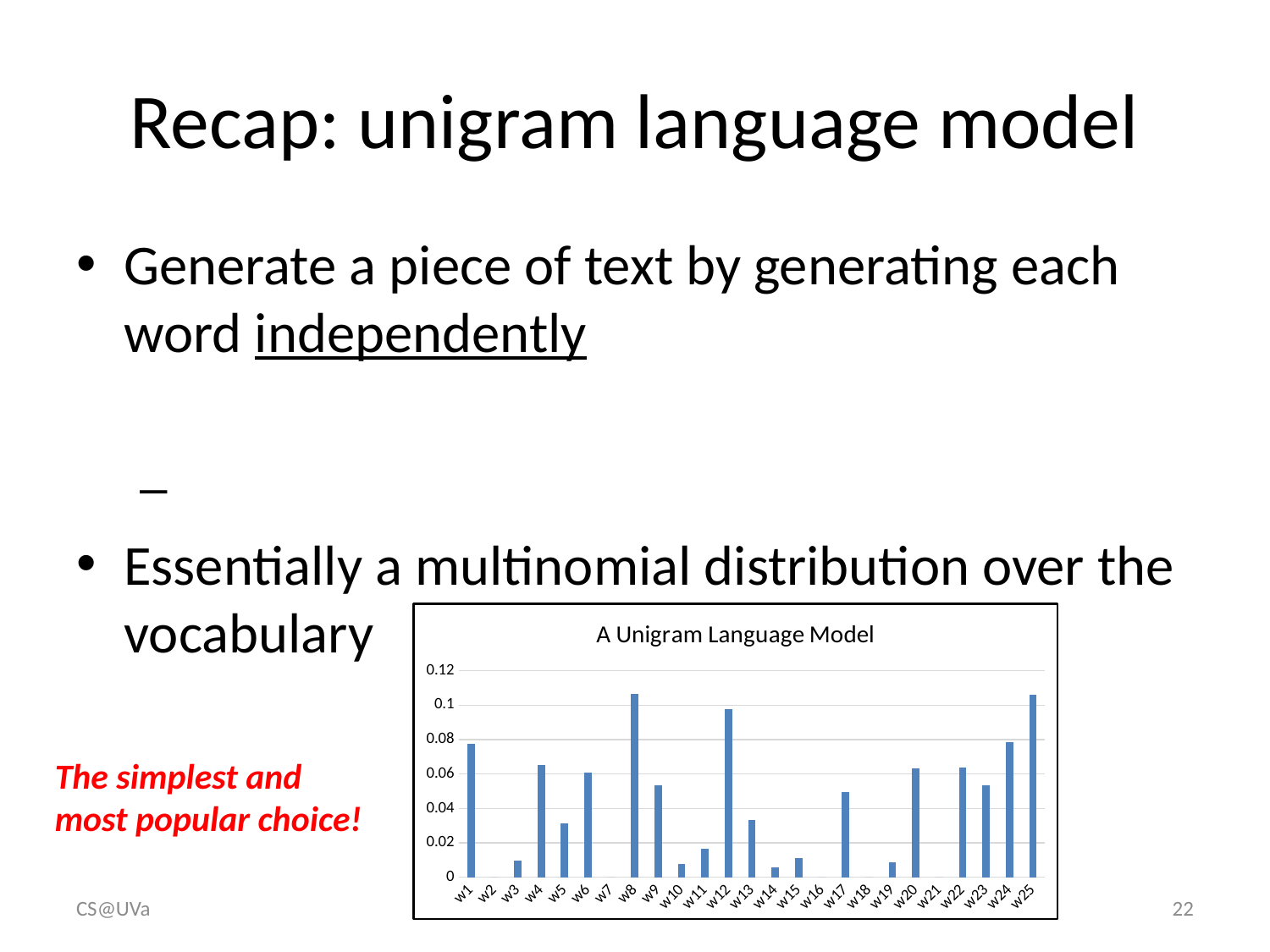
Is the value for w8 greater or less than 0.1? greater Which has a larger value, w1 or w5? w1 Is the value for w17 greater or less than 0.06? less What is the highest value labelled on the y axis of the chart? 0.12 How many word categories are shown on the x axis of the chart? 25 Is the value for w1 greater or less than 0.06? greater Which has a larger value, w8 or w12? w8 What kind of chart is shown on the slide? bar chart What is the title of the chart? A Unigram Language Model